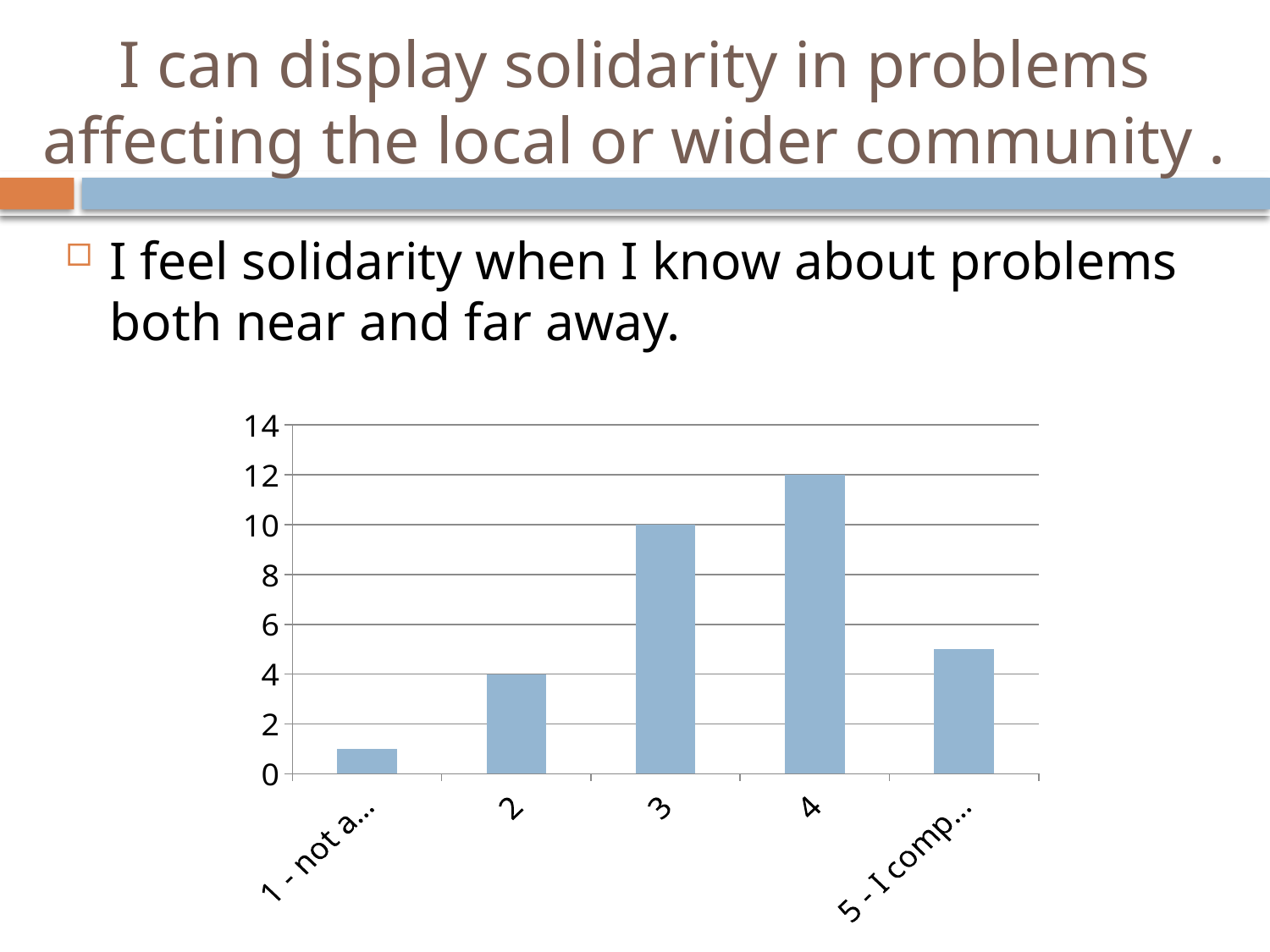
Which category has the lowest bar? 1 - not a… What kind of chart is shown on the slide? bar chart What is the value for category 3? 10 Is the value for the first category (1 - not a…) greater or less than 2? less What is the value for category 2? 4 Which is larger, the value for category 2 or the value for category 3? 3 What is the value for category 4? 12 Which category has the highest bar? 4 Is the value for the last category (5 - I comp…) greater or less than 4? greater What is the difference between the values for category 3 and category 2? 6 How many categories are shown on the x axis? 5 What is the difference between the values for category 4 and category 3? 2